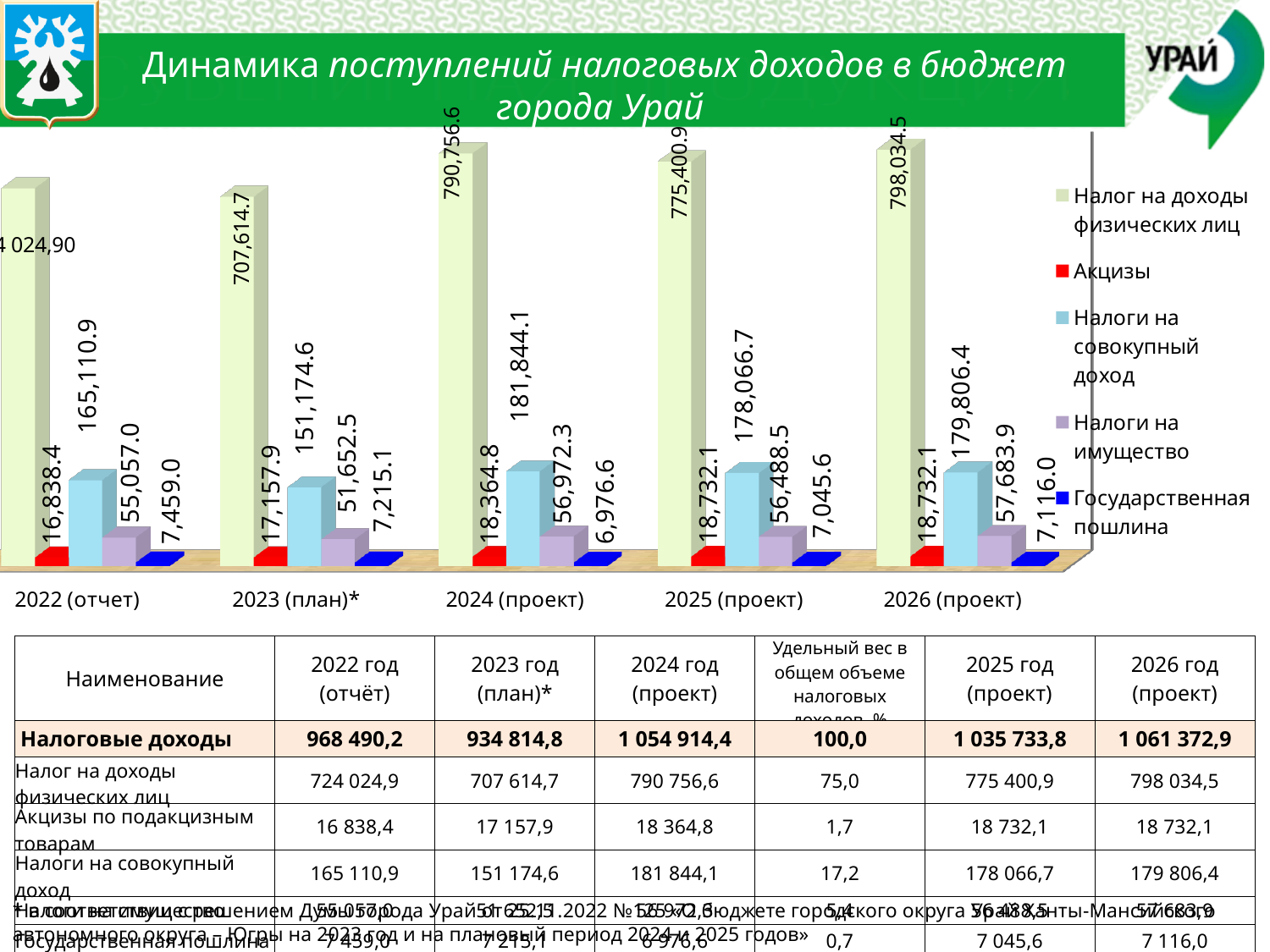
How many series does the chart legend list? 5 What type of chart is shown on the slide? bar chart How many year categories are shown along the x axis of the chart? 5 In which year is Налог на доходы физических лиц the highest? 2026 (проект) In which year is Государственная пошлина the lowest? 2024 (проект) What is the value of Государственная пошлина for 2026 (проект)? 7,116.0 What is the value of Налог на доходы физических лиц for 2024 (проект)? 790,756.6 What is the value of Налоги на совокупный доход for 2023 (план)*? 151,174.6 What is the difference between Налоги на имущество in 2026 (проект) and 2025 (проект)? 1,195.4 What is the value of Акцизы for 2025 (проект)? 18,732.1 Which is larger: Налоги на совокупный доход in 2024 (проект) or in 2025 (проект)? 2024 (проект) Which series is shown in red in the chart legend? Акцизы